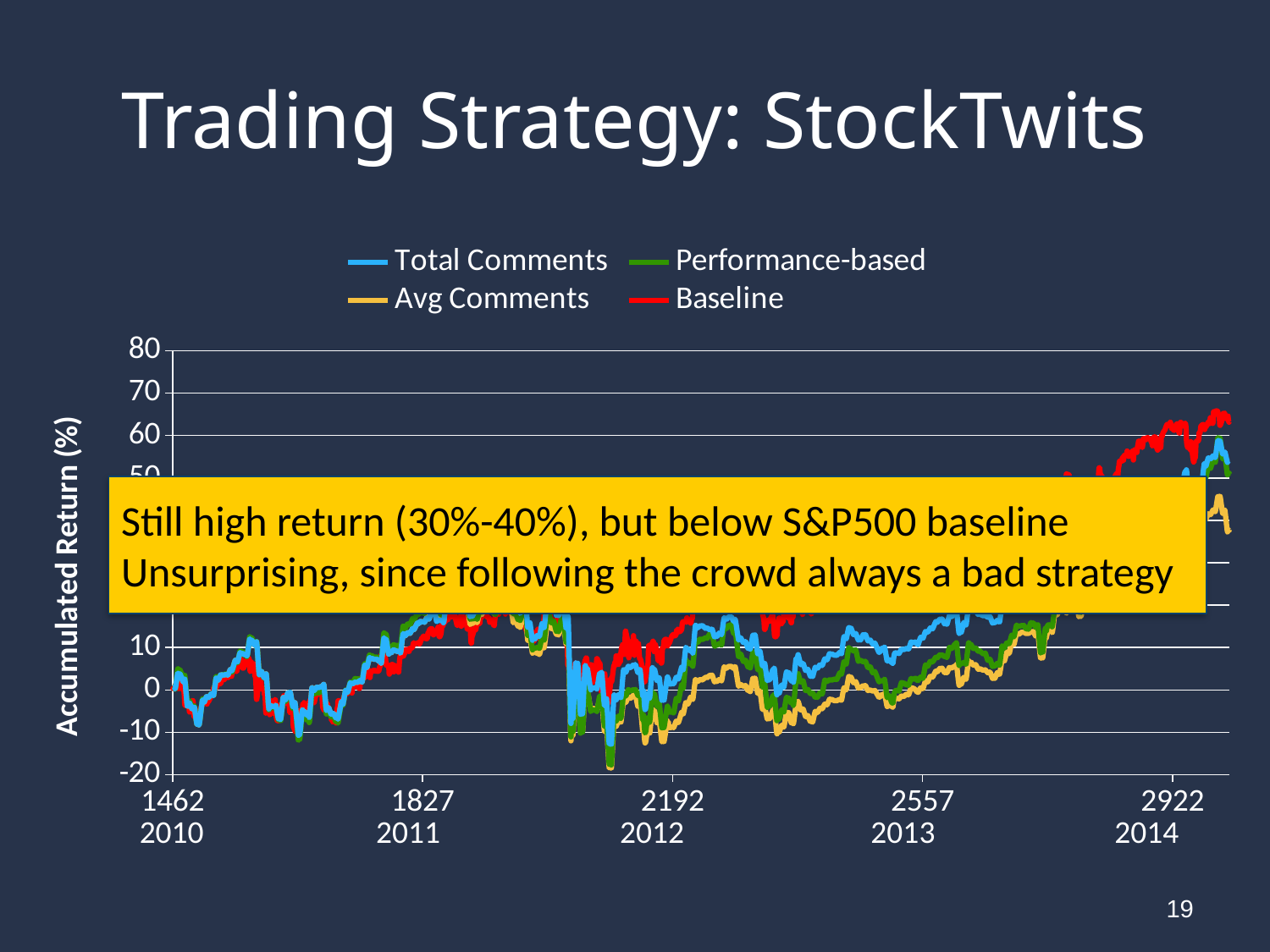
Which series has the lowest value at the right-hand end of the chart (2014)? Avg Comments What is the highest value shown on the y axis? 80 Which series has the highest value at the right-hand end of the chart (2014)? Baseline At the right-hand end of the chart, is the Baseline value larger or smaller than the Avg Comments value? larger Does the Baseline series overall rise or fall from 2010 to 2014? rise What kind of chart is shown on the slide? line chart How many year labels are shown along the x axis? 5 What is the label of the vertical axis? Accumulated Return (%) Is the value of the Baseline series at the right-hand end of the chart greater or less than 50? greater Is the lowest value reached by the Avg Comments series (around 2012) greater or less than -10? less Which series is drawn in red according to the legend? Baseline How many series does the legend list? 4